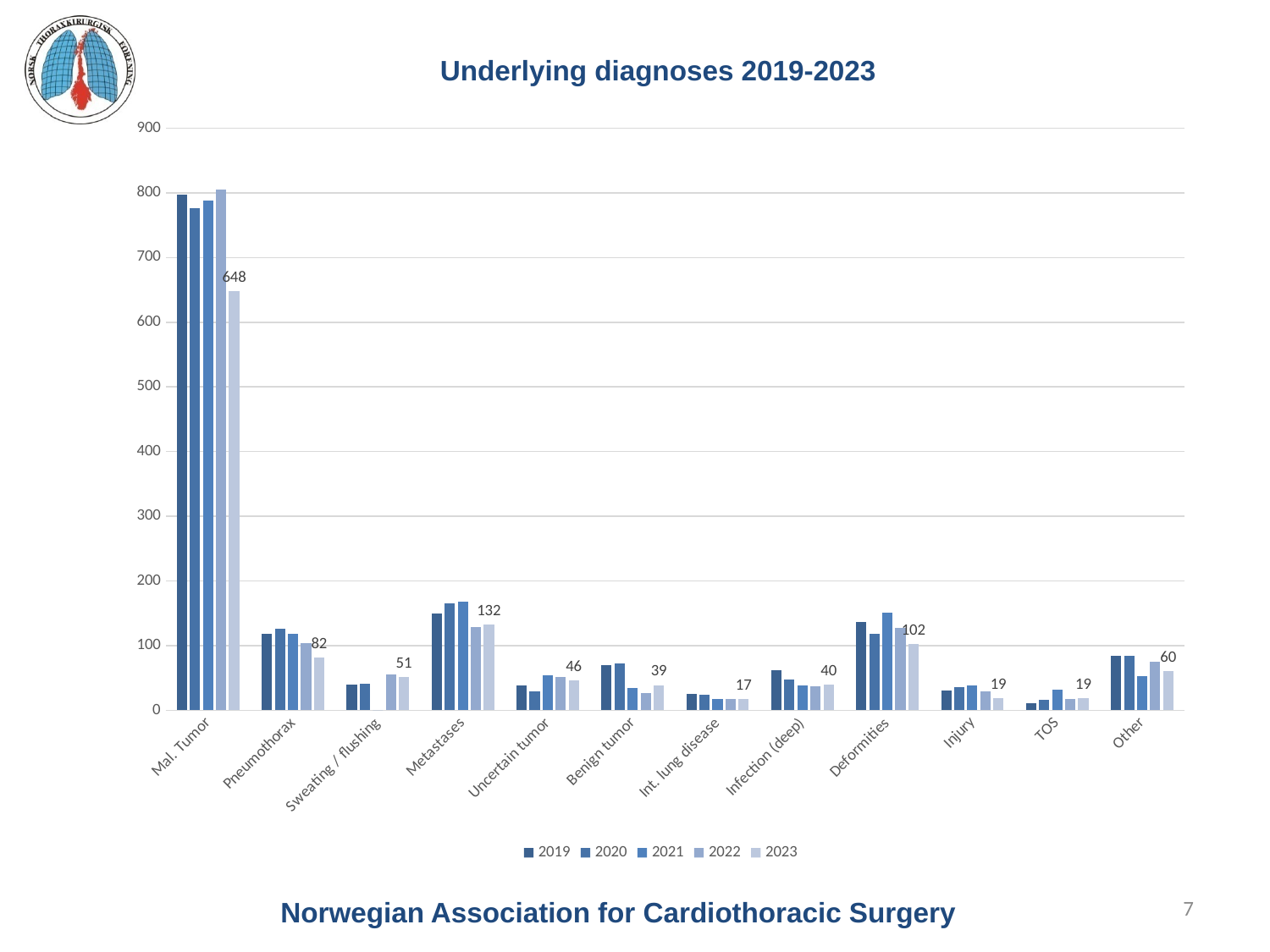
What is the value for Deformities in 2023? 102 What is the value for Int. lung disease in 2023? 17 How many series does the legend list? 5 Which category has the lowest value in 2023? Int. lung disease What kind of chart is shown on the slide? Bar chart Is the value for Mal. Tumor in 2019 greater or less than 700? greater Which is larger in 2023, Sweating / flushing or Uncertain tumor? Sweating / flushing What is the value for Mal. Tumor in 2023? 648 How many diagnosis categories are shown on the x axis? 12 Which category has the highest value in 2023? Mal. Tumor What is the difference between the 2023 values for Pneumothorax and Other? 22 What is the value for Metastases in 2023? 132